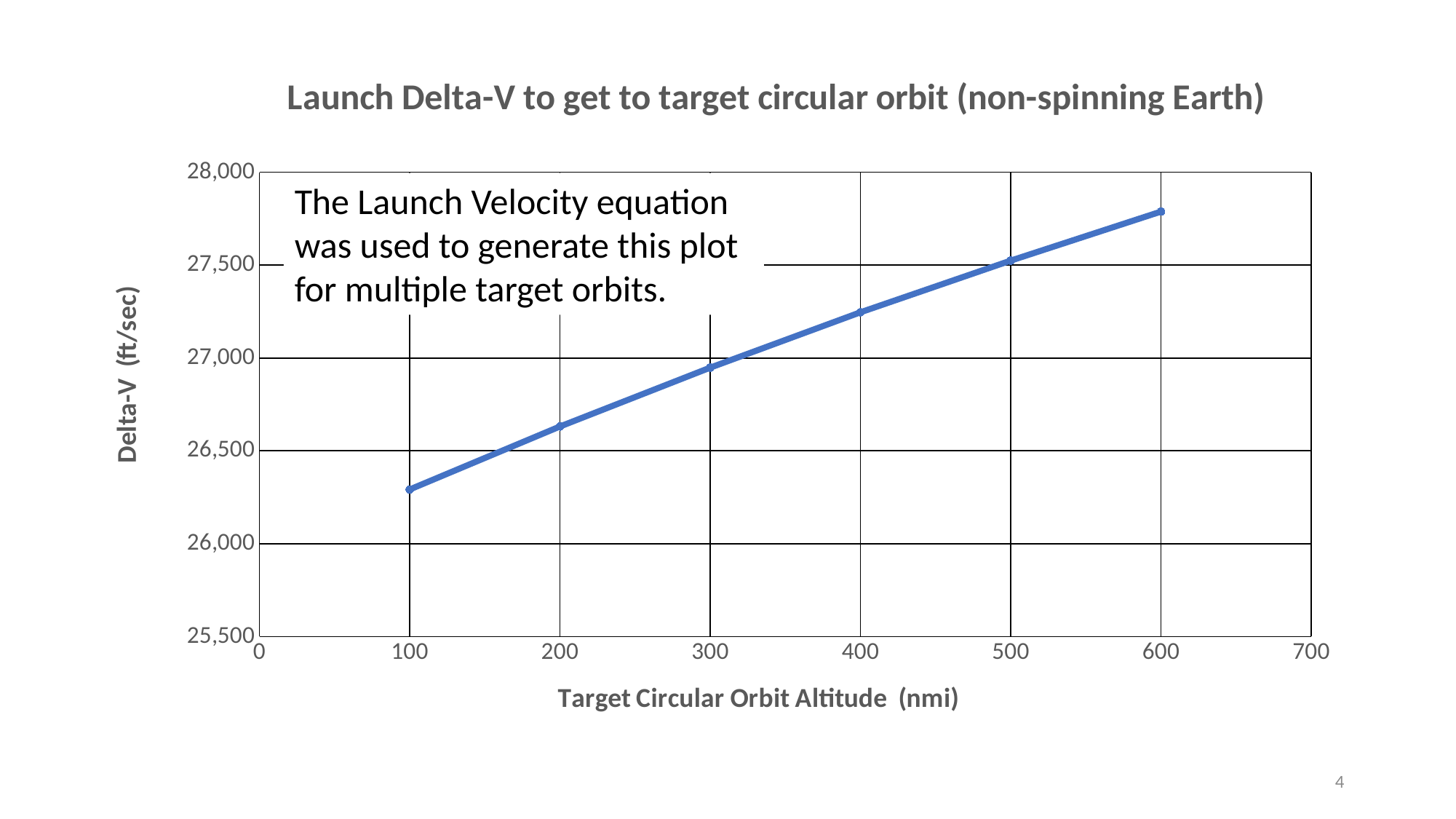
Is the Delta-V value at 100 nmi greater or less than 26,500? less Which has the larger Delta-V, the 300 nmi orbit or the 500 nmi orbit? 500 nmi At which target circular orbit altitude is the Delta-V lowest? 100 What kind of chart is shown on the slide? line chart What is the title of the chart? Launch Delta-V to get to target circular orbit (non-spinning Earth) What is the label of the y axis? Delta-V (ft/sec) How many data points are plotted on the line? 6 Is the Delta-V value at 200 nmi greater or less than 26,500? greater Is the Delta-V value at 600 nmi greater or less than 27,500? greater At which target circular orbit altitude is the Delta-V highest? 600 Does Delta-V rise or fall as the target circular orbit altitude increases? rise